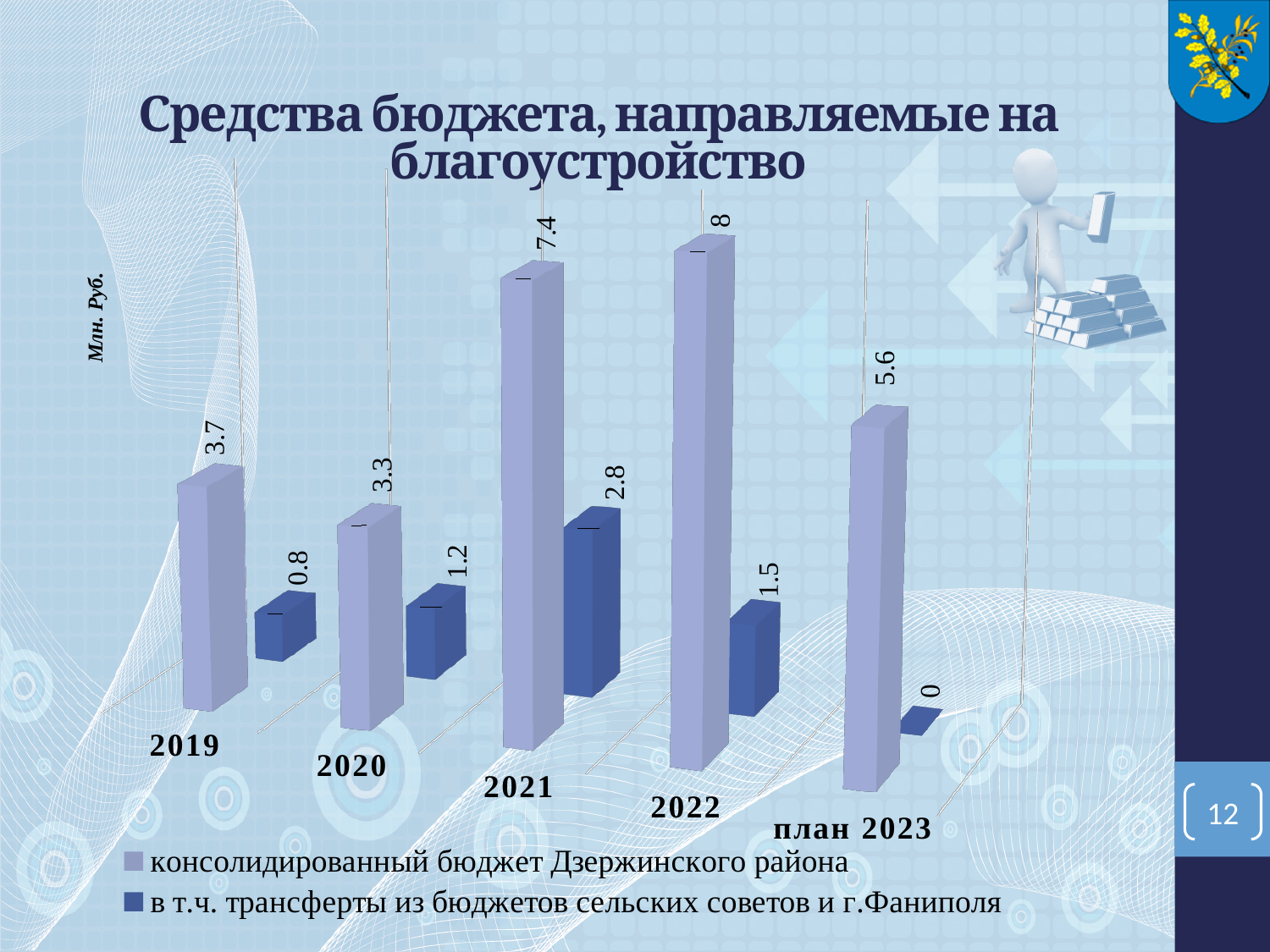
How many categories are shown on the x axis? 5 What kind of chart is shown on the slide? bar chart How many series does the legend list? 2 Which is larger: the консолидированный бюджет Дзержинского района value for 2019 or for 2020? 2019 In which year is the консолидированный бюджет Дзержинского района value highest? 2022 What is the difference between the консолидированный бюджет Дзержинского района values for 2022 and 2021? 0.6 In which category is the в т.ч. трансферты из бюджетов сельских советов и г.Фаниполя value lowest? план 2023 Does the в т.ч. трансферты из бюджетов сельских советов и г.Фаниполя series rise or fall from 2021 to план 2023? fall What is the value of the консолидированный бюджет Дзержинского района series for 2021? 7.4 What is the value of the консолидированный бюджет Дзержинского района series for план 2023? 5.6 What is the value of the в т.ч. трансферты из бюджетов сельских советов и г.Фаниполя series for 2020? 1.2 What unit is shown on the vertical axis label of the chart? Млн. Руб.